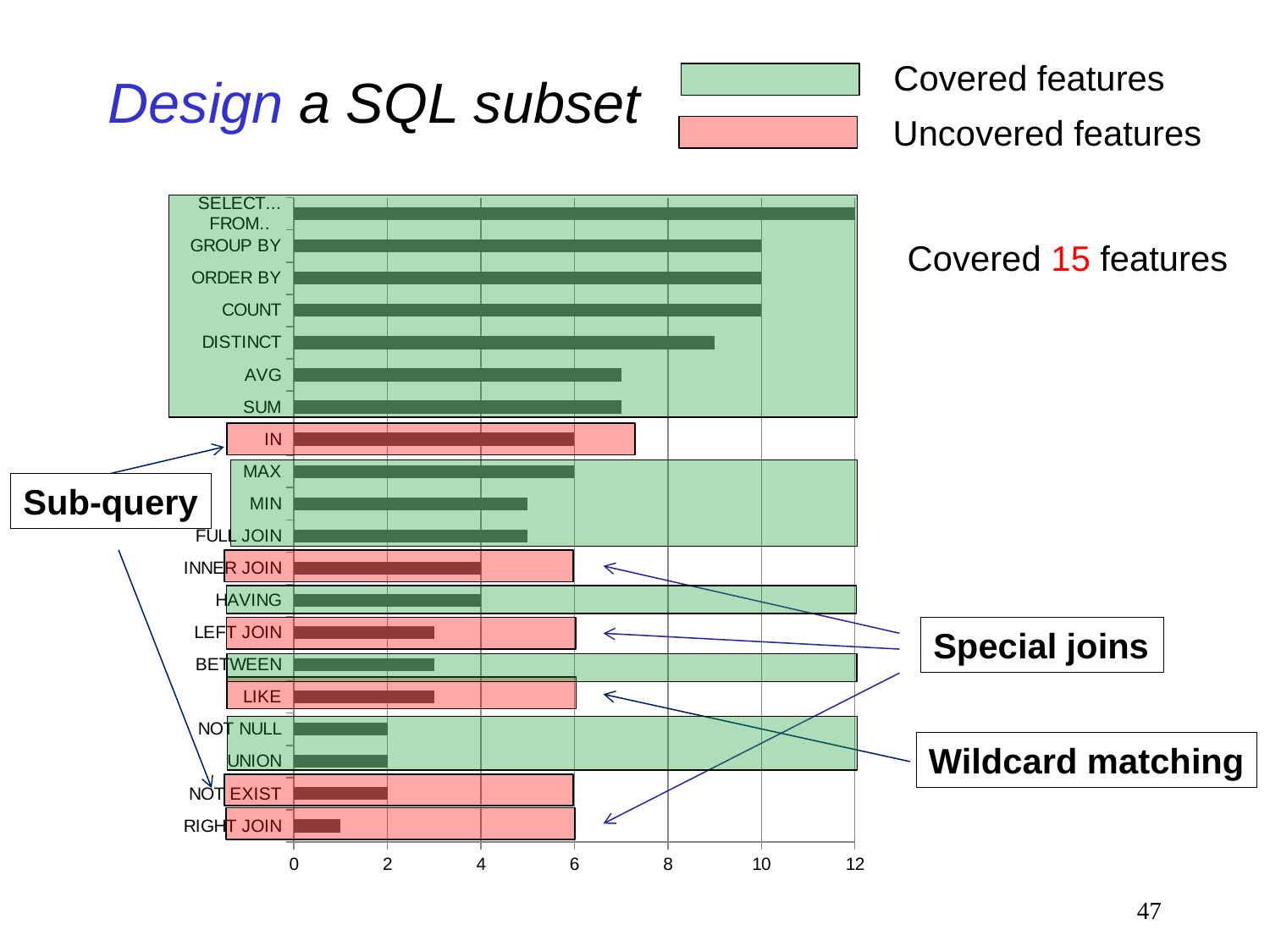
Which is larger, the value for MAX or the value for MIN? MAX What is the value for IN? 6 How many entries does the legend list? 2 What is the value for GROUP BY? 10 What is the value for SELECT... FROM..? 12 What kind of chart is shown on the slide? bar chart What is the value for HAVING? 4 Which category has the shortest bar in the chart? RIGHT JOIN Is the value for DISTINCT greater or less than 8? greater How many categories are plotted in the chart? 20 Which category has the longest bar in the chart? SELECT... FROM.. What is the difference between the values for COUNT and INNER JOIN? 6